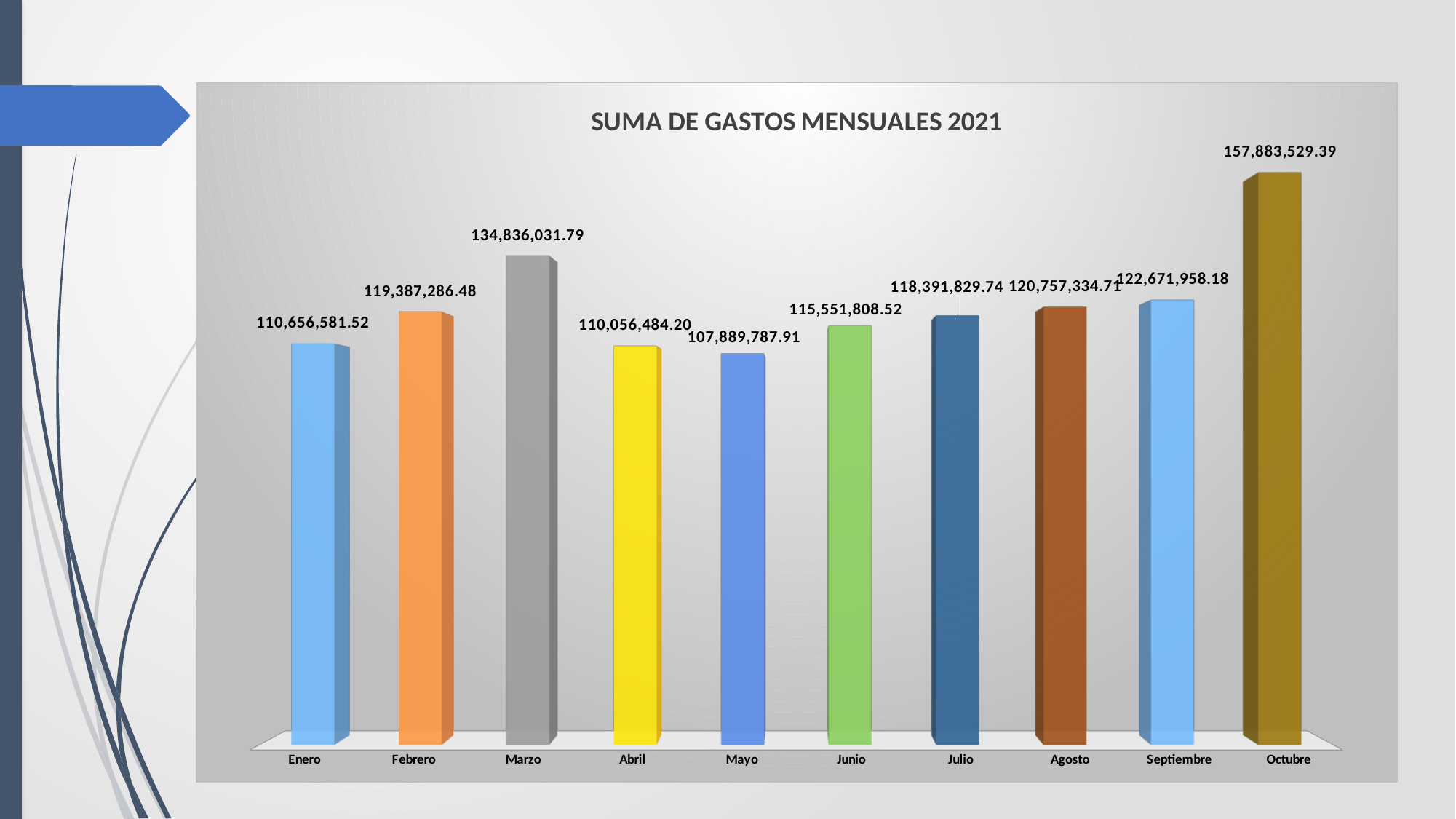
What is the value for Agosto? 120,757,334.71 What is the difference between the values for Febrero and Enero? 8,730,704.96 Which month has the lowest value? Mayo Which is larger, the value for Septiembre or the value for Agosto? Septiembre What is the value for Marzo? 134,836,031.79 How many months are shown on the chart? 10 Which month has the highest value? Octubre What kind of chart is shown on the slide? Bar chart What is the title of the chart? SUMA DE GASTOS MENSUALES 2021 What is the difference between the values for Octubre and Marzo? 23,047,497.60 What is the value for Mayo? 107,889,787.91 What is the value for Septiembre? 122,671,958.18